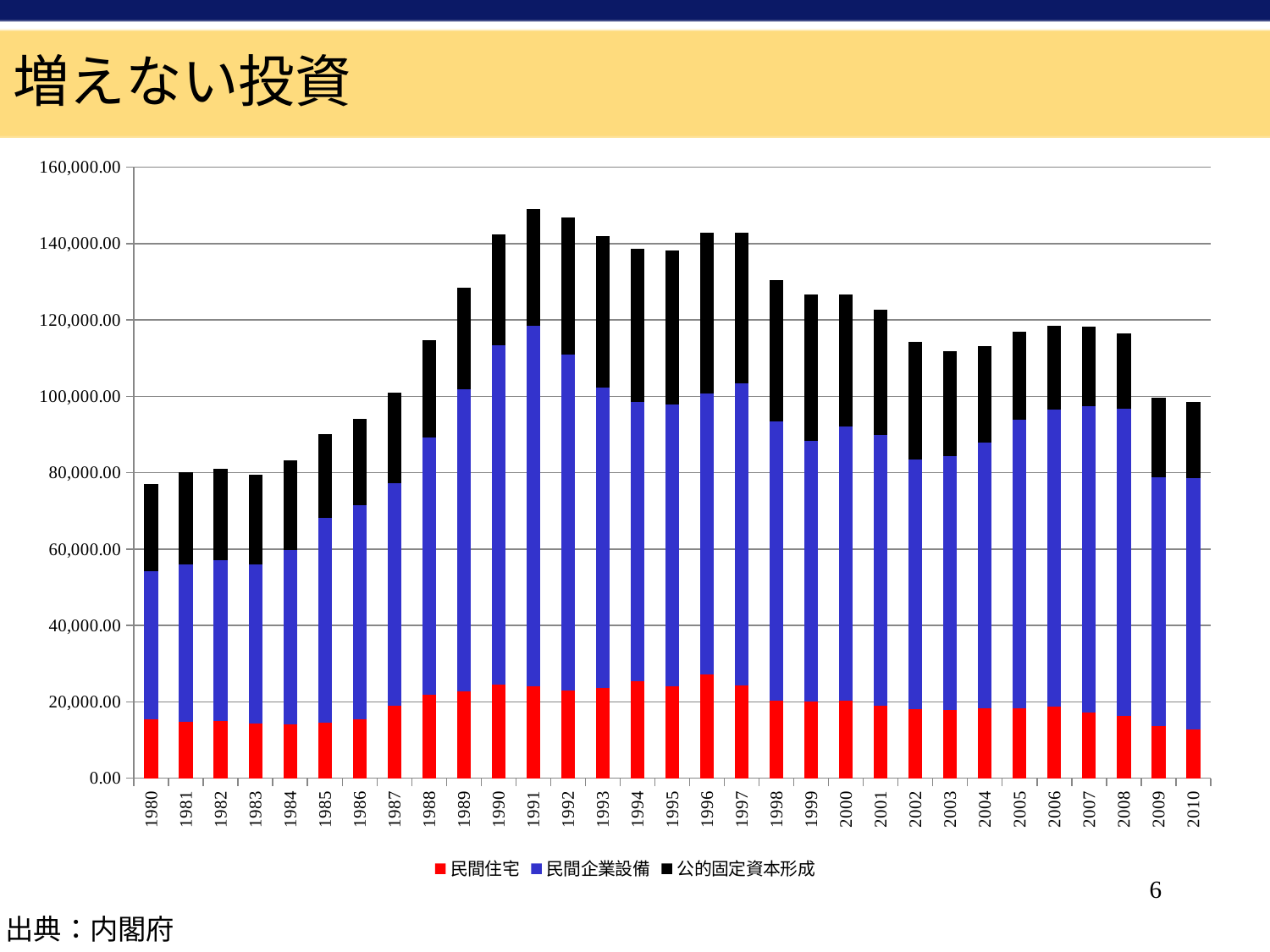
Which year has the tallest stacked bar (highest total)? 1991 How many series does the legend list? 3 What is the title of the slide? 増えない投資 Do the stacked totals generally rise or fall from 1991 to 2010? fall Which series is shown in red? 民間住宅 How many years are shown along the x axis? 31 Is the total for 1980 greater or less than 80,000.00? less Is the total for 1988 greater or less than 100,000.00? greater What kind of chart is shown on the slide? Stacked bar chart Is the total for 2010 greater or less than 100,000.00? less Which year has the larger total, 1997 or 2002? 1997